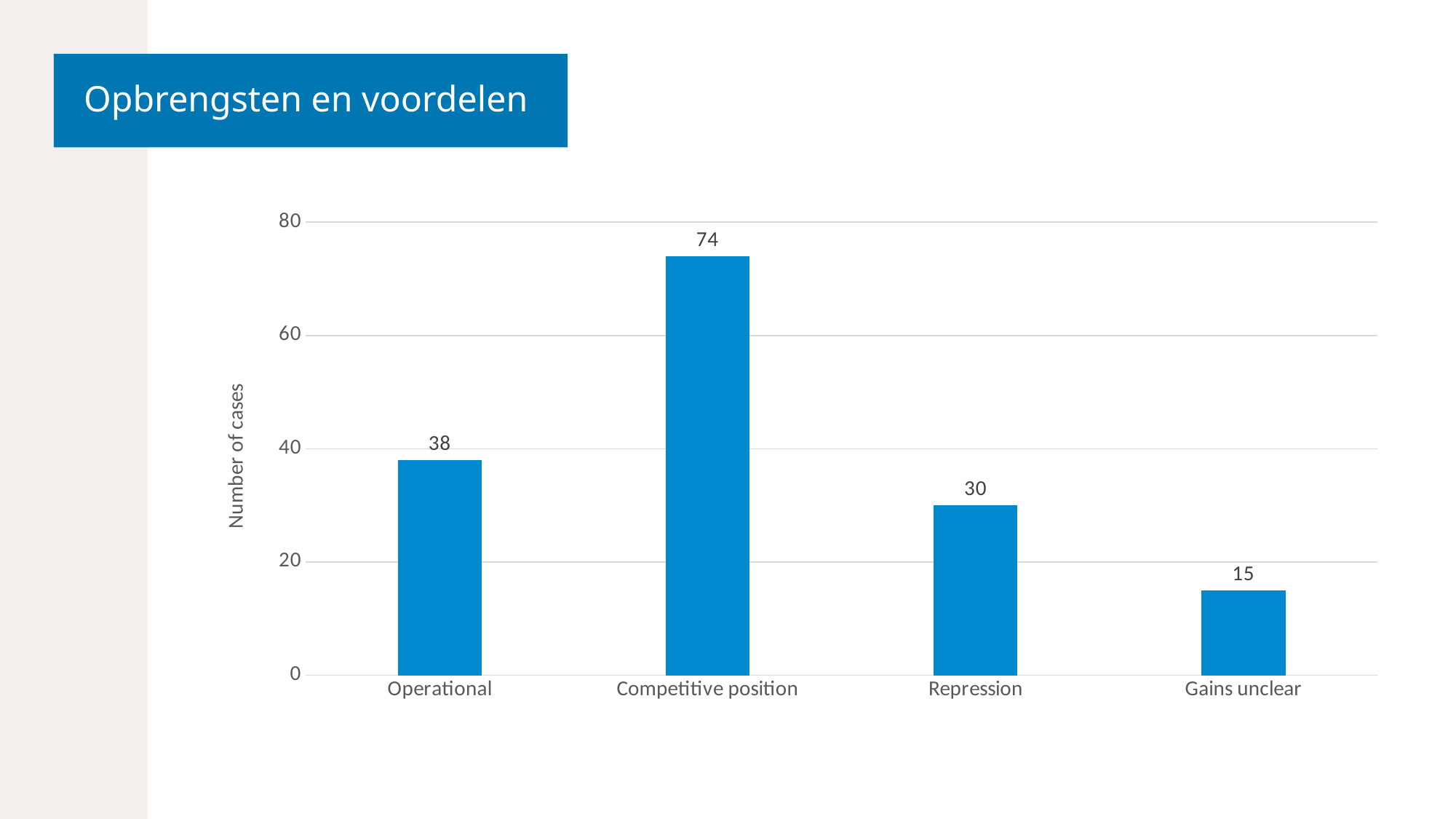
How many categories are shown on the x axis? 4 What is the difference in number of cases between Competitive position and Operational? 36 What is the number of cases for Gains unclear? 15 Which category has the highest number of cases? Competitive position Is the value for Competitive position greater or less than 60? greater What is the difference in number of cases between Repression and Gains unclear? 15 What is the number of cases for Competitive position? 74 Which has more cases, Operational or Repression? Operational Which category has the lowest number of cases? Gains unclear What is the number of cases for Repression? 30 What kind of chart is shown on the slide? Bar chart What is the number of cases for Operational? 38